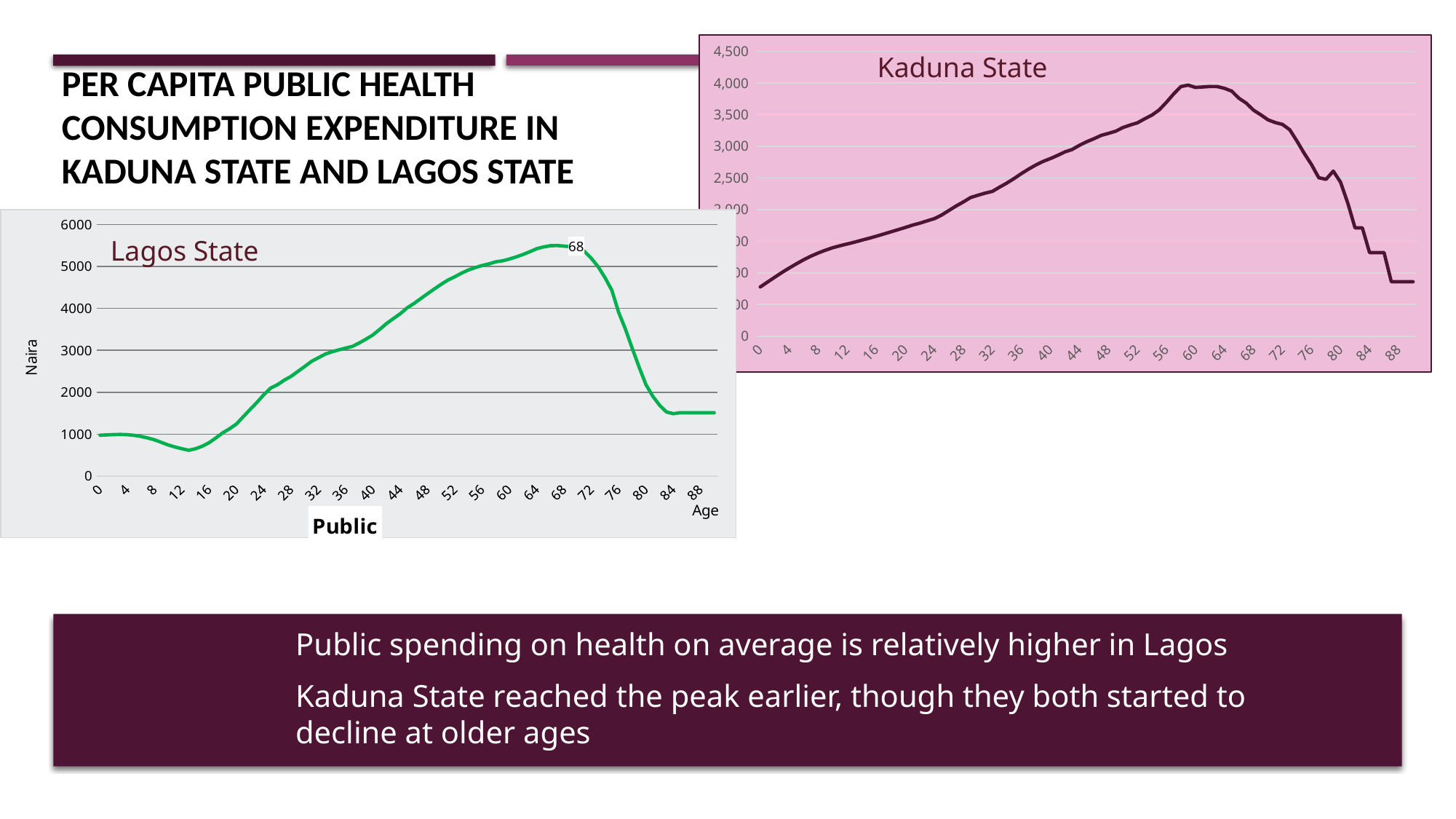
In the Kaduna State chart, does the line rise or fall between age 64 and age 88? fall In the Kaduna State chart, is the value at age 40 greater or less than 2,500? greater What kind of chart is the Kaduna State chart? line chart In the Lagos State chart, does the line rise or fall between age 20 and age 68? rise In the Lagos State chart, at what age does the line reach its highest value? 68 In the Kaduna State chart, is the highest value on the line greater or less than 4,500? less In the Kaduna State chart, is the value at age 88 greater or less than 1,000? less In the Lagos State chart, what is the label on the vertical axis? Naira What kind of chart is the Lagos State chart? line chart